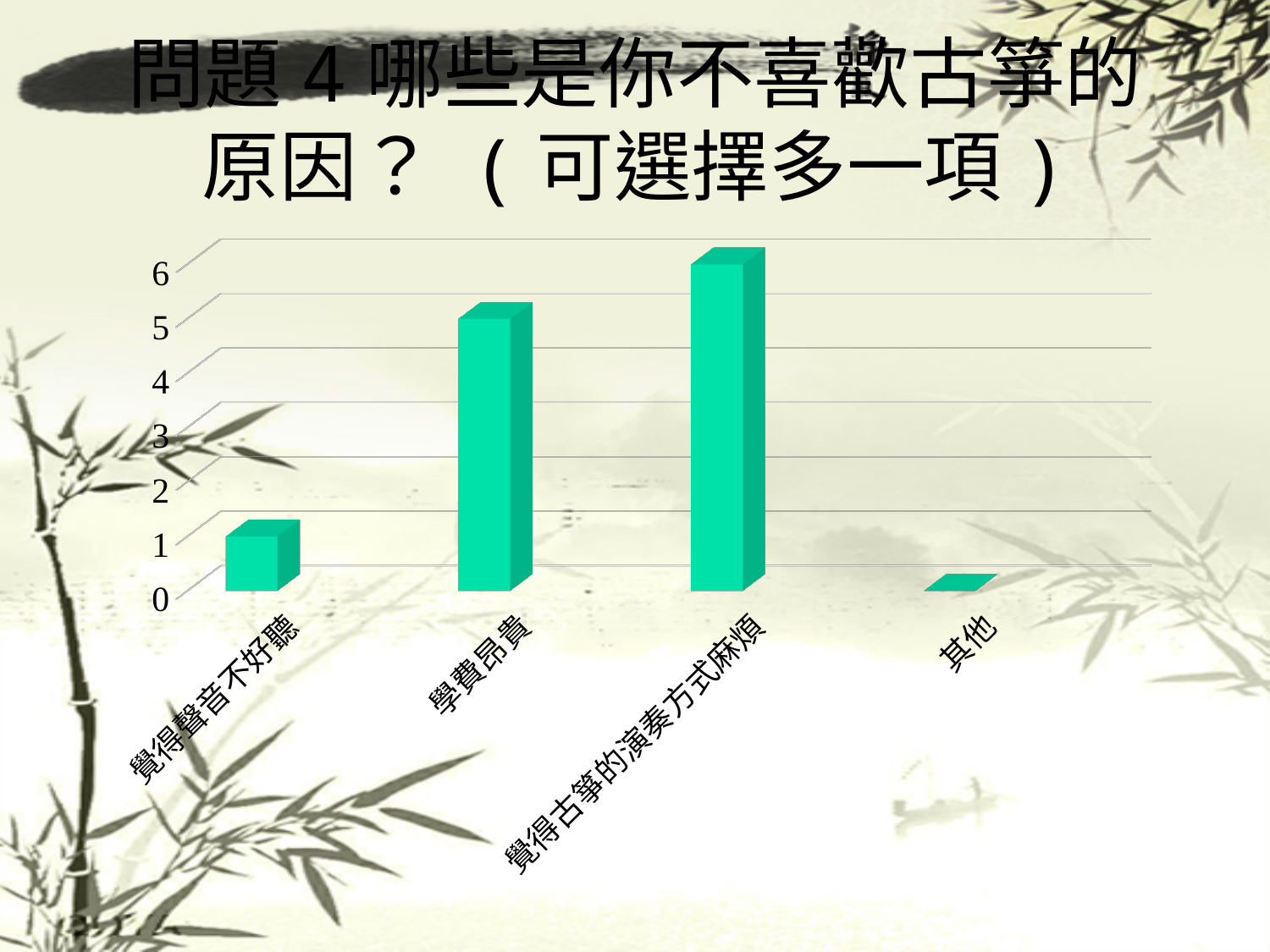
Is the value for 覺得聲音不好聽 greater or less than 2? less What is the value for 其他 in the chart? 0 Is the value for 學費昂貴 greater or less than 4? greater Which category has the highest bar in the chart? 覺得古箏的演奏方式麻煩 What kind of chart is shown on the slide? bar chart Which category has the lowest bar in the chart? 其他 Is the value for 覺得古箏的演奏方式麻煩 greater or less than 5? greater Which is larger, the value for 學費昂貴 or the value for 覺得聲音不好聽? 學費昂貴 Which is larger, the value for 覺得古箏的演奏方式麻煩 or the value for 其他? 覺得古箏的演奏方式麻煩 What colour are the bars in the chart? green How many categories are shown on the x axis of the chart? 4 What is the highest value shown on the vertical axis of the chart? 6